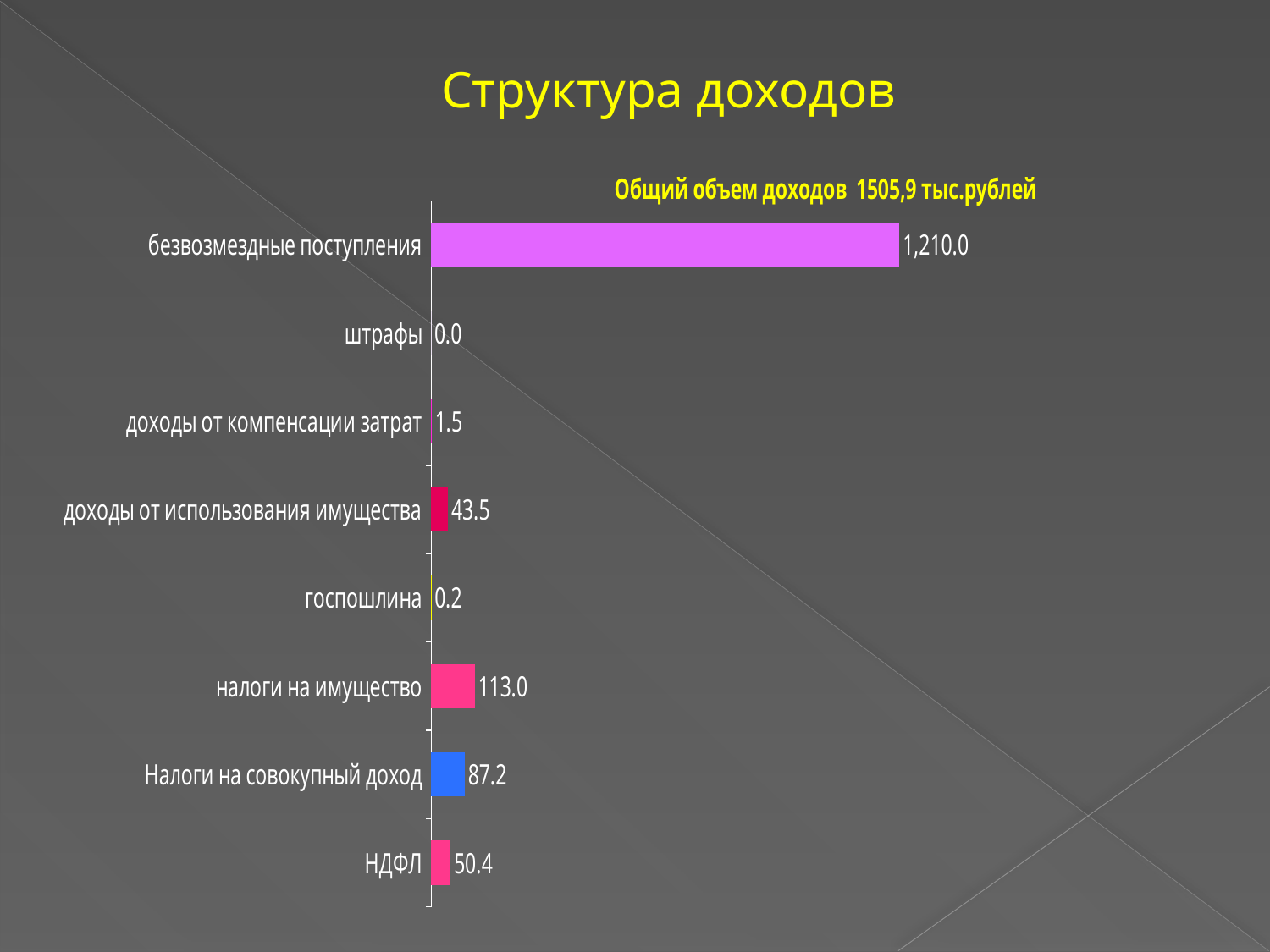
What is the value for штрафы? 0.0 What total income volume is stated above the chart? 1505,9 тыс.рублей How many categories are shown in the chart? 8 Which category has the lowest value? штрафы What is the value for безвозмездные поступления? 1,210.0 What kind of chart is shown on the slide? bar chart What is the value for доходы от использования имущества? 43.5 Which category has the highest value? безвозмездные поступления Which is larger, Налоги на совокупный доход or НДФЛ? Налоги на совокупный доход What is the value for налоги на имущество? 113.0 What is the difference between налоги на имущество and Налоги на совокупный доход? 25.8 What is the value for НДФЛ? 50.4